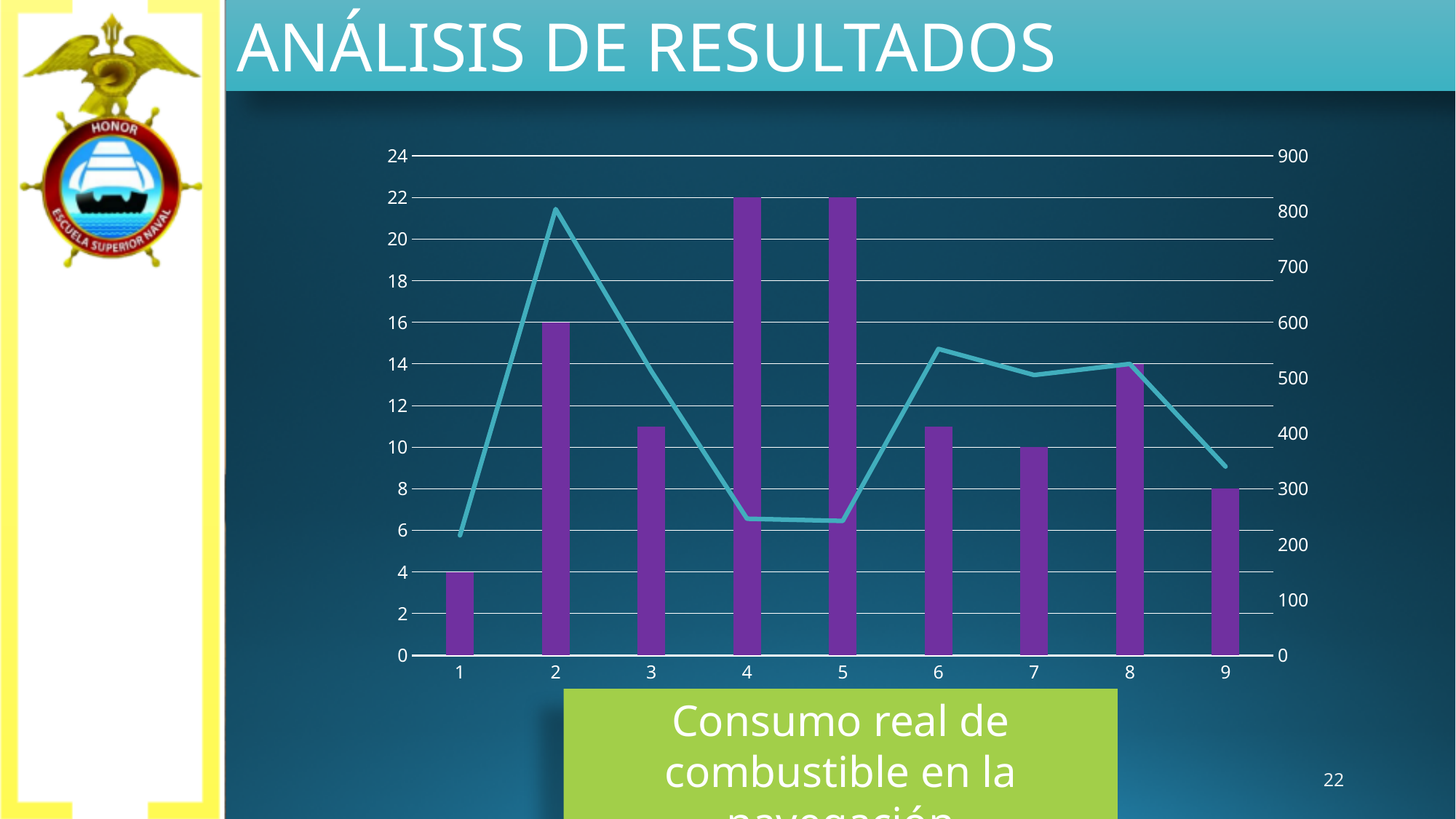
What is the value of the bar for category 8 on the left axis? 14 Which has the taller bar, category 2 or category 8? 2 How many categories are shown on the x axis of the chart? 9 Does the line rise or fall from category 8 to category 9? fall Is the bar value for category 3 greater or less than 10? greater Which categories have the tallest bars? 4 and 5 Is the line value for category 2 on the right axis greater or less than 700? greater What is the difference between the bar values for category 2 and category 9? 8 Which category has the shortest bar? 1 What is the value of the bar for category 1 on the left axis? 4 What is the value of the bar for category 4 on the left axis? 22 What kind of chart is shown on the slide? bar and line chart